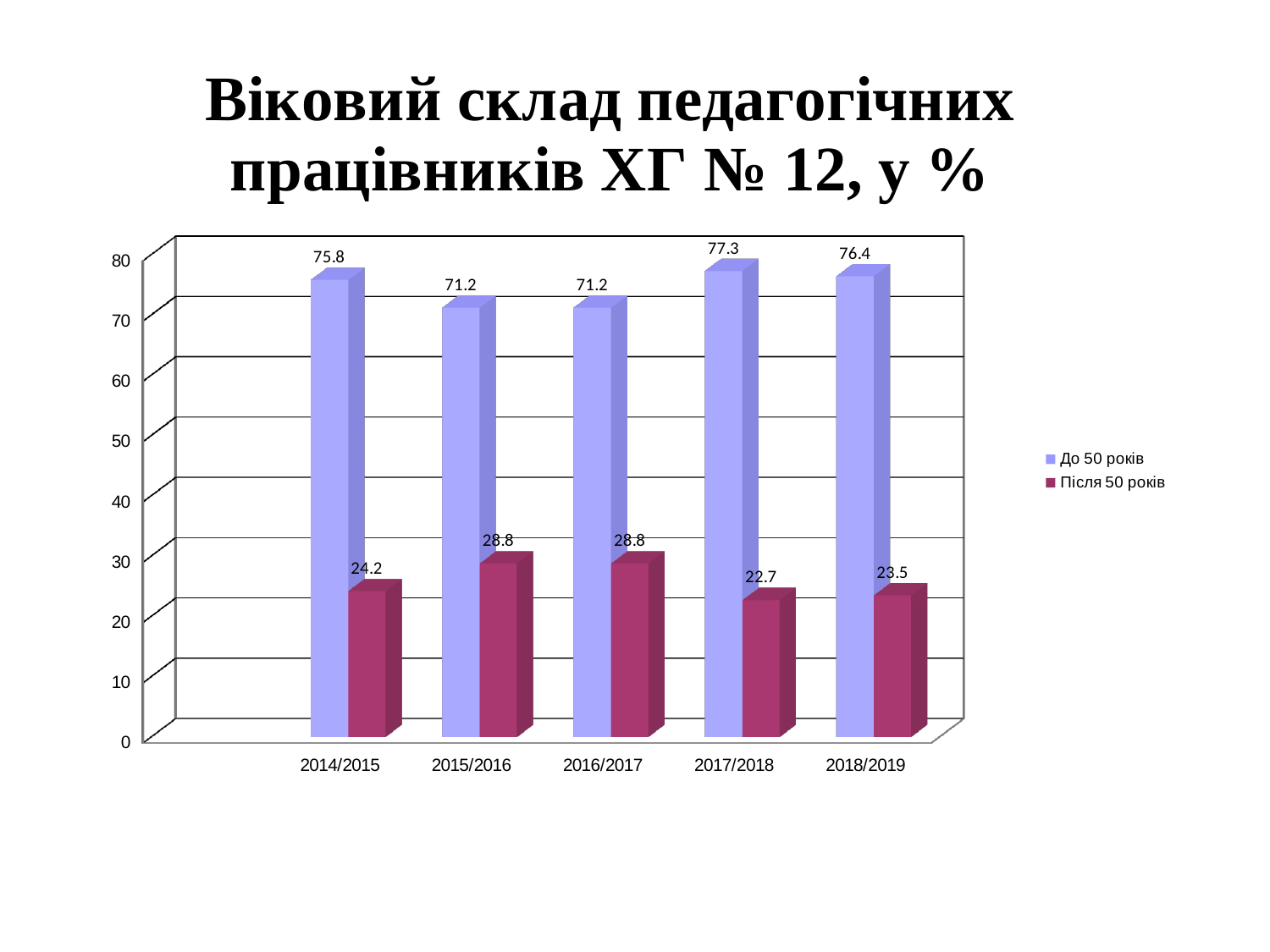
Is the value for "Після 50 років" in 2014/2015 greater or less than 30? less What is the value for "Після 50 років" in 2018/2019? 23.5 In which year is the value for "Після 50 років" lowest? 2017/2018 In which year is the value for "До 50 років" highest? 2017/2018 What is the value for "До 50 років" in 2014/2015? 75.8 What is the value for "Після 50 років" in 2017/2018? 22.7 What is the difference between the "До 50 років" and "Після 50 років" values in 2015/2016? 42.4 Which is larger: the "До 50 років" value in 2018/2019 or in 2016/2017? 2018/2019 What is the title of the chart on the slide? Віковий склад педагогічних працівників ХГ № 12, у % How many series does the legend list? 2 How many school years are shown on the x axis? 5 What kind of chart is shown on the slide? bar chart